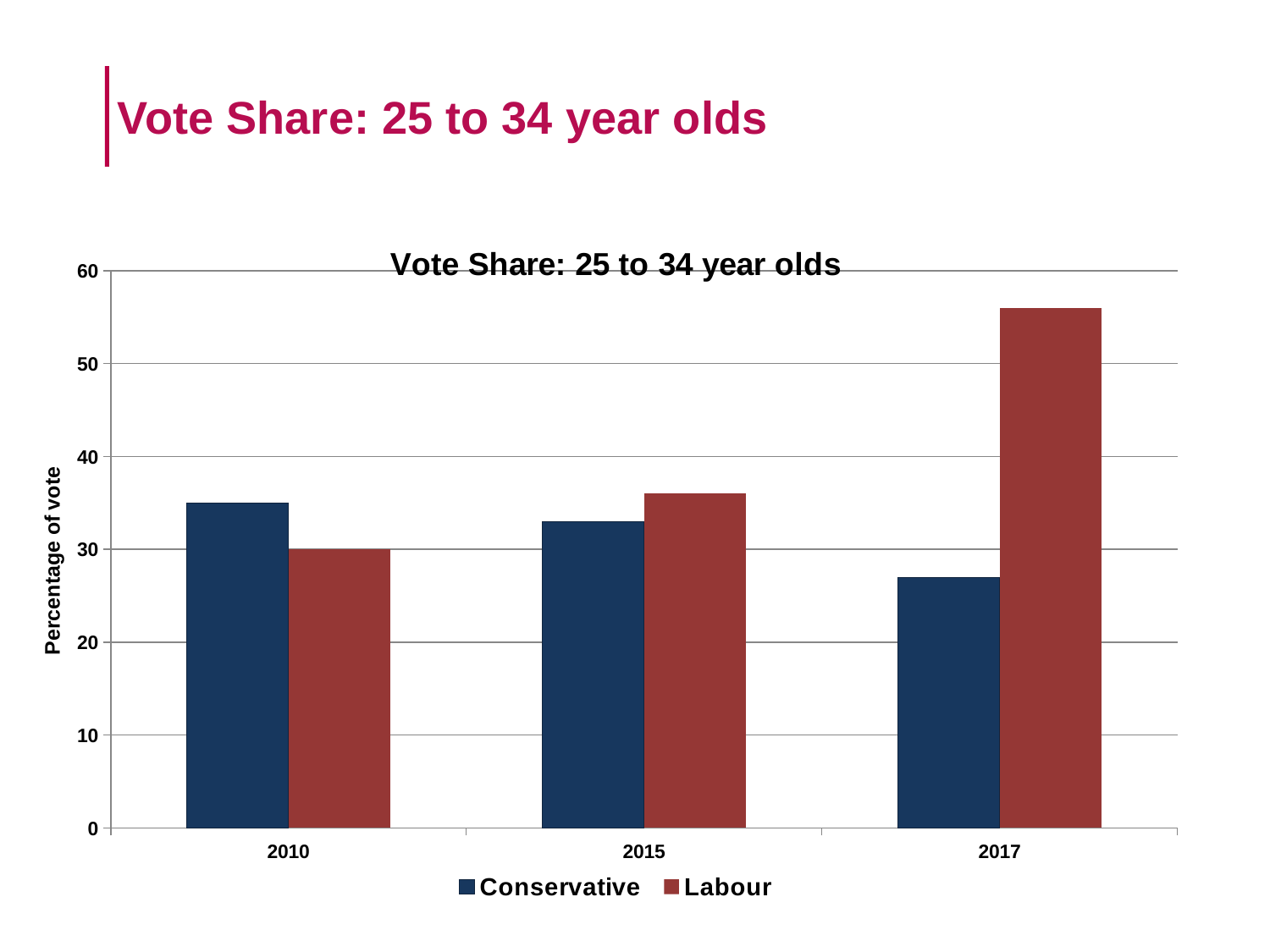
Does the Conservative vote share rise or fall from 2010 to 2017? fall Is the value for Labour in 2017 greater or less than 50? greater What is the label on the y axis? Percentage of vote How many series does the legend list? 2 In 2017, which party has the larger vote share, Conservative or Labour? Labour Which bar is the lowest in the chart? Conservative in 2017 What is the Labour vote share in 2010? 30 Which bar is the highest in the chart? Labour in 2017 In 2010, which party has the larger vote share, Conservative or Labour? Conservative How many years are shown on the x axis? 3 Is the value for Conservative in 2017 greater or less than 30? less What kind of chart is shown on the slide? bar chart